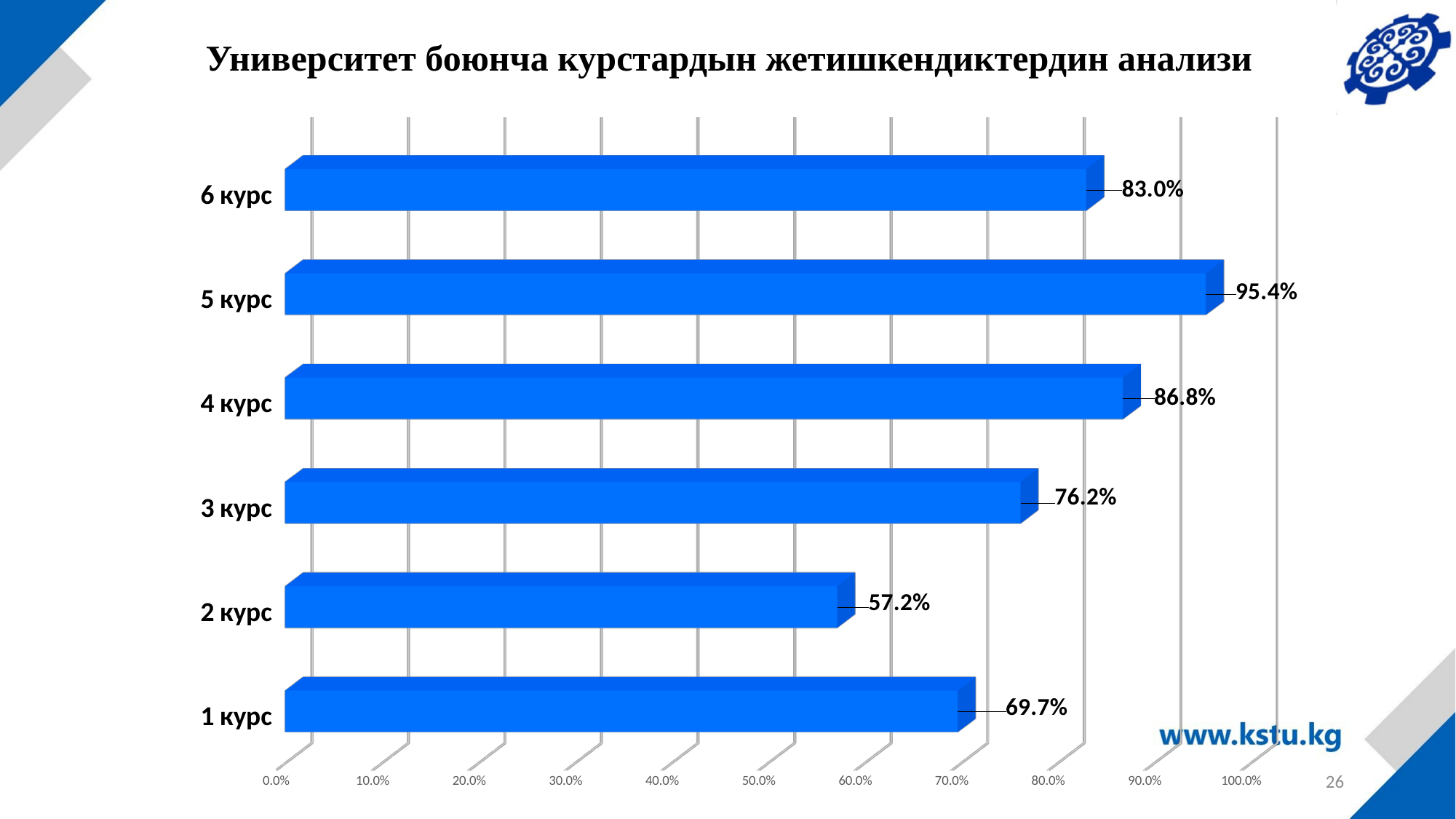
How many courses are shown in the chart? 6 Which course has the lowest value? 2 курс What is the value for 2 курс? 57.2% Which course has the highest value? 5 курс What is the difference between the values for 5 курс and 2 курс? 38.2% What kind of chart is shown on the slide? Bar chart What is the title of the chart on the slide? Университет боюнча курстардын жетишкендиктердин анализи What is the value for 5 курс? 95.4% What is the difference between the values for 6 курс and 3 курс? 6.8% What is the value for 4 курс? 86.8% What is the value for 1 курс? 69.7% Which is larger, the value for 4 курс or the value for 6 курс? 4 курс